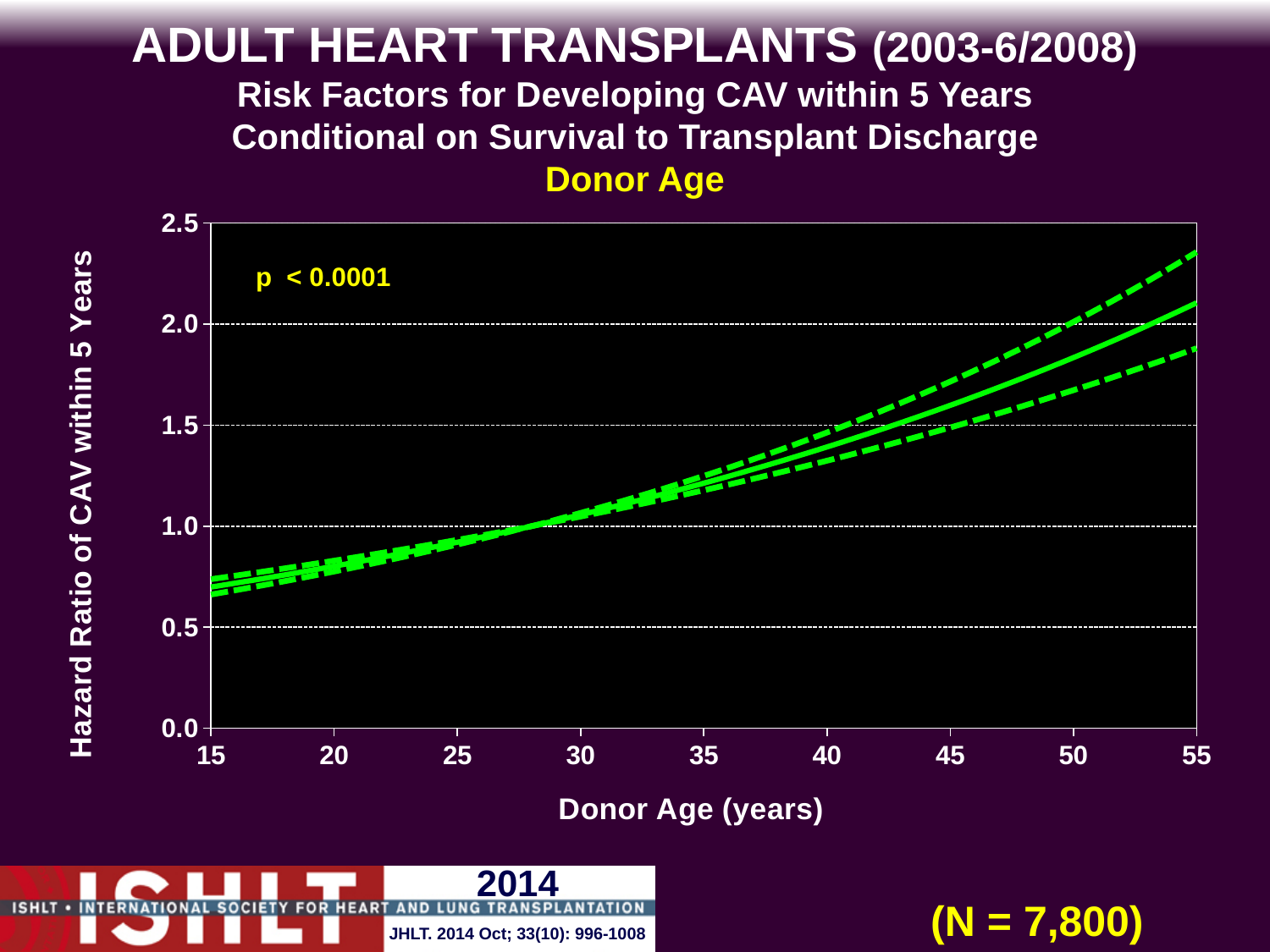
Is the hazard ratio for a donor age of 50 years greater or less than 1.5? greater Is the hazard ratio for a donor age of 55 years greater or less than 1.5? greater How many lines are plotted on the chart? 3 Is the hazard ratio for a donor age of 35 years greater or less than 1.5? less What is the label of the x axis? Donor Age (years) What is the highest value shown on the y axis? 2.5 Which donor age has the higher hazard ratio, 20 years or 45 years? 45 years What kind of chart is shown on the slide? line chart Does the hazard ratio of CAV rise or fall as donor age increases from 15 to 55 years? rise What p-value is printed on the chart? p < 0.0001